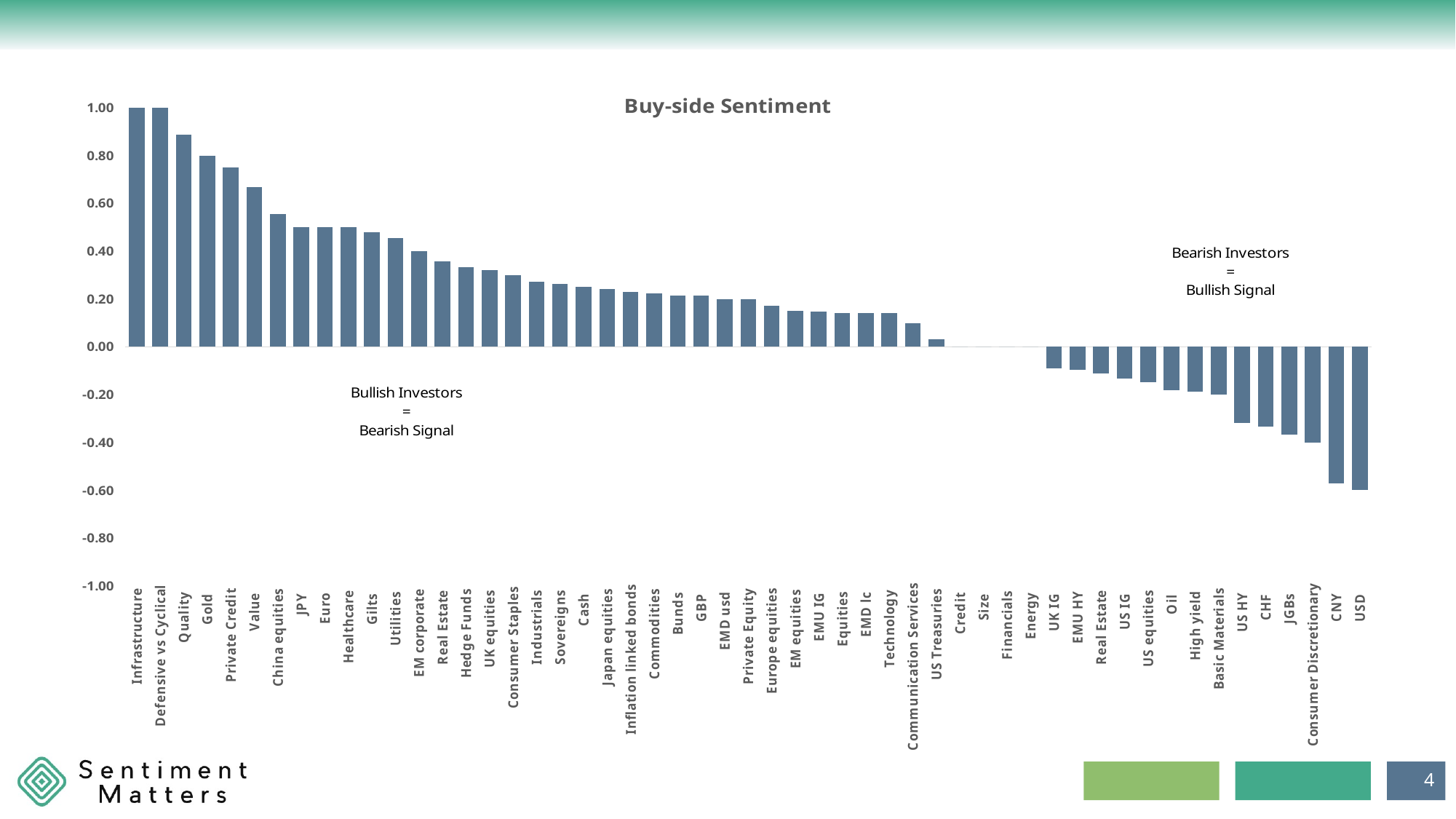
What kind of chart is shown on the slide? Bar chart Is the value for Value greater or less than 0.60? greater How many categories are plotted on the x axis of the Buy-side Sentiment chart? 53 According to the annotation on the right side of the chart, bearish investors equal what kind of signal? Bullish Signal Is the value for US HY greater or less than -0.20? less Do the values rise or fall moving from left to right along the x axis? Fall Which category has the lowest value in the Buy-side Sentiment chart? USD Which has the larger value, Gold or Private Credit? Gold Is the value for CNY greater or less than -0.40? less What is the title of the chart? Buy-side Sentiment